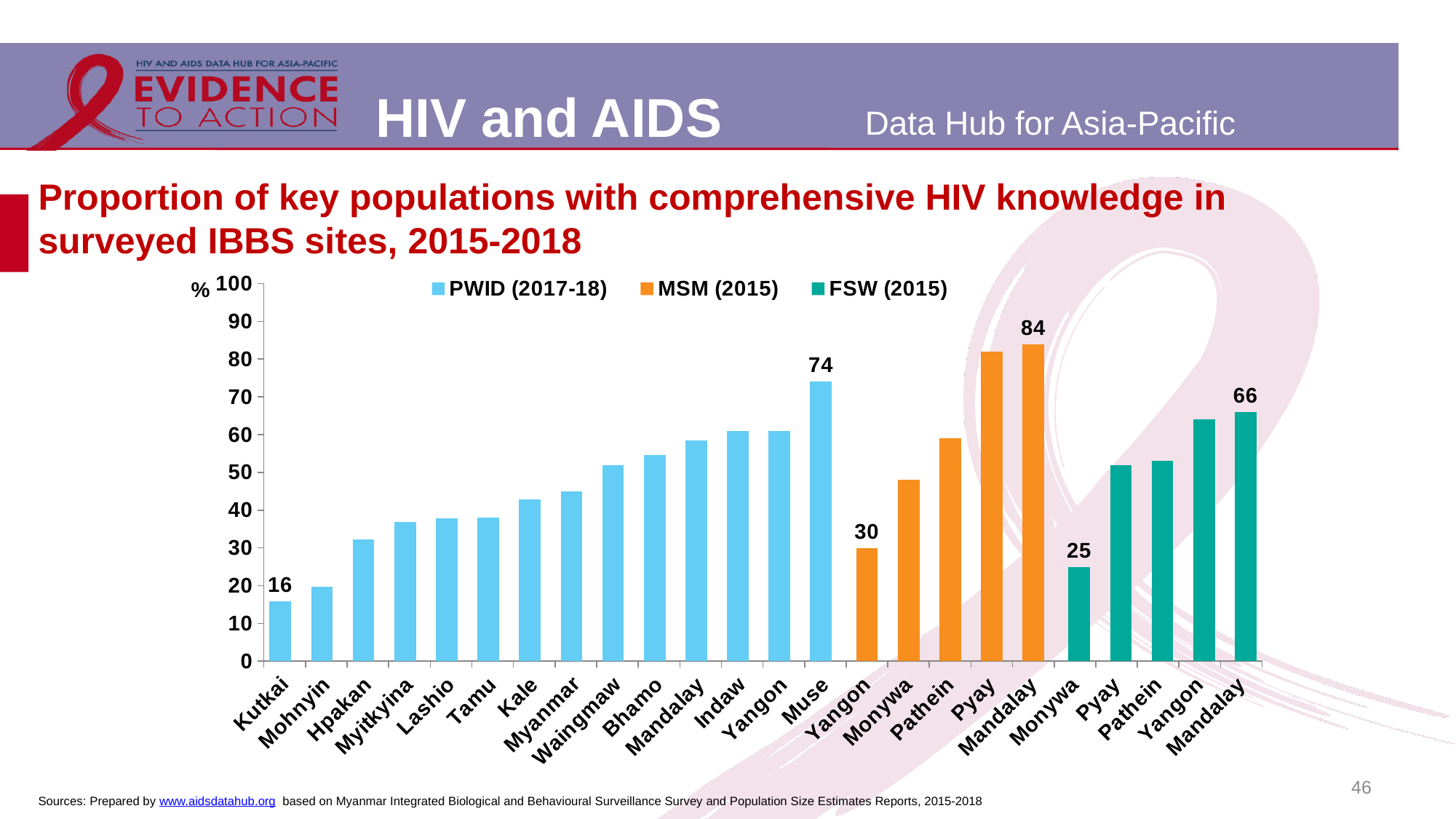
Which is larger: the PWID value for Muse or the FSW value for Mandalay? PWID value for Muse (74) What is the difference between the MSM values for Mandalay and Yangon? 54 What is the value for Muse in the PWID (2017-18) series? 74 Which site and population has the highest proportion with comprehensive HIV knowledge? Mandalay (MSM), 84 What is the value for Kutkai in the PWID (2017-18) series? 16 What is the value for Monywa in the FSW (2015) series? 25 How many series does the legend list? 3 Is the PWID value for Hpakan greater or less than 40? less What is the value for Mandalay in the MSM (2015) series? 84 What is the difference between the PWID values for Muse and Kutkai? 58 What is the value for Yangon in the MSM (2015) series? 30 Which site has the lowest proportion with comprehensive HIV knowledge across all series? Kutkai (PWID), 16